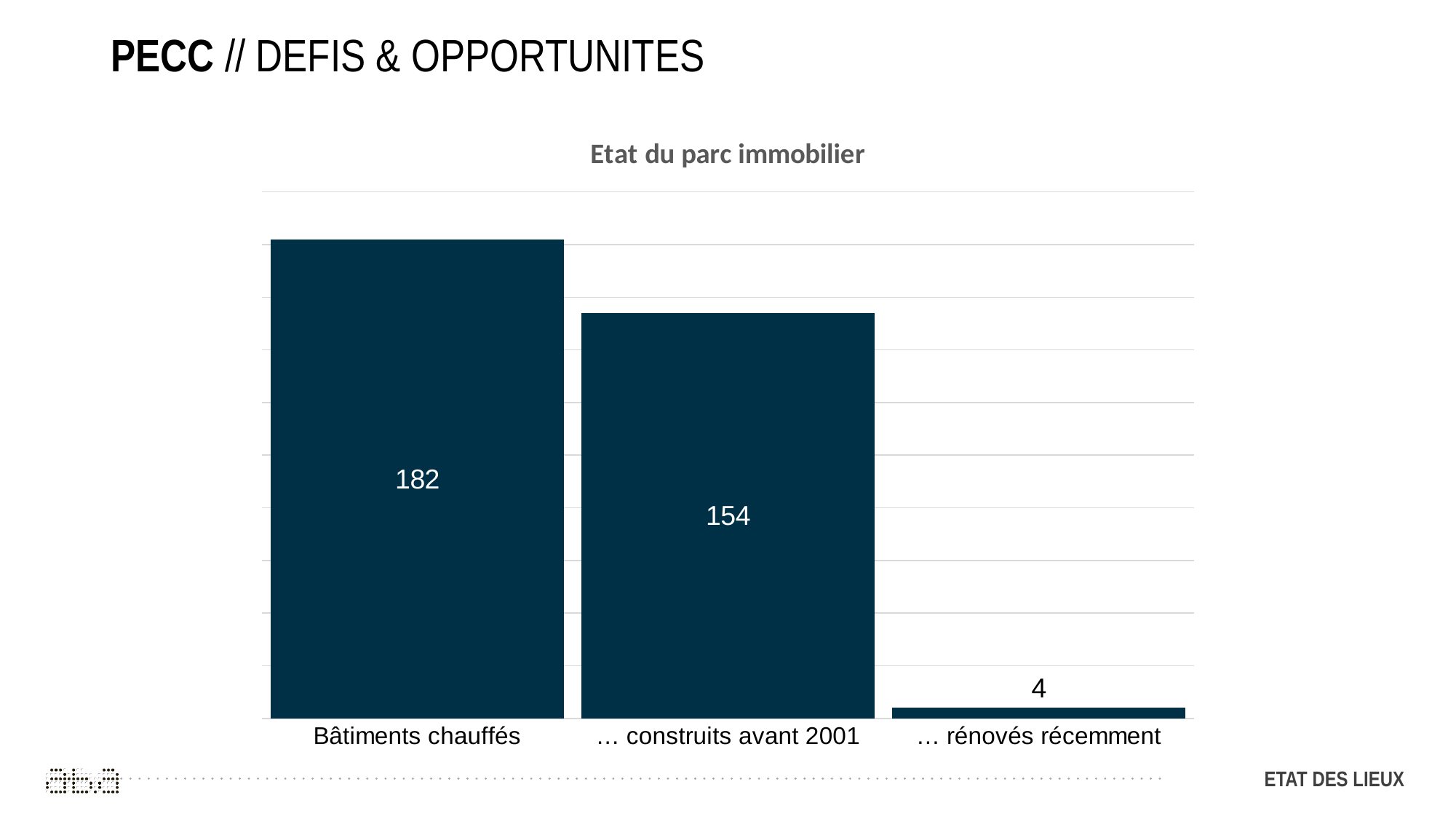
What is the title of the chart? Etat du parc immobilier How many categories are shown in the chart? 3 Do the values rise or fall from left to right across the categories? fall What kind of chart is shown on the slide? bar chart What is the value for … construits avant 2001? 154 What is the difference between the values for … construits avant 2001 and … rénovés récemment? 150 What is the value for … rénovés récemment? 4 What is the value for Bâtiments chauffés? 182 Which category has the lowest value? … rénovés récemment Which category has the highest value? Bâtiments chauffés Which is larger, the value for … construits avant 2001 or the value for … rénovés récemment? … construits avant 2001 What is the difference between the values for Bâtiments chauffés and … construits avant 2001? 28